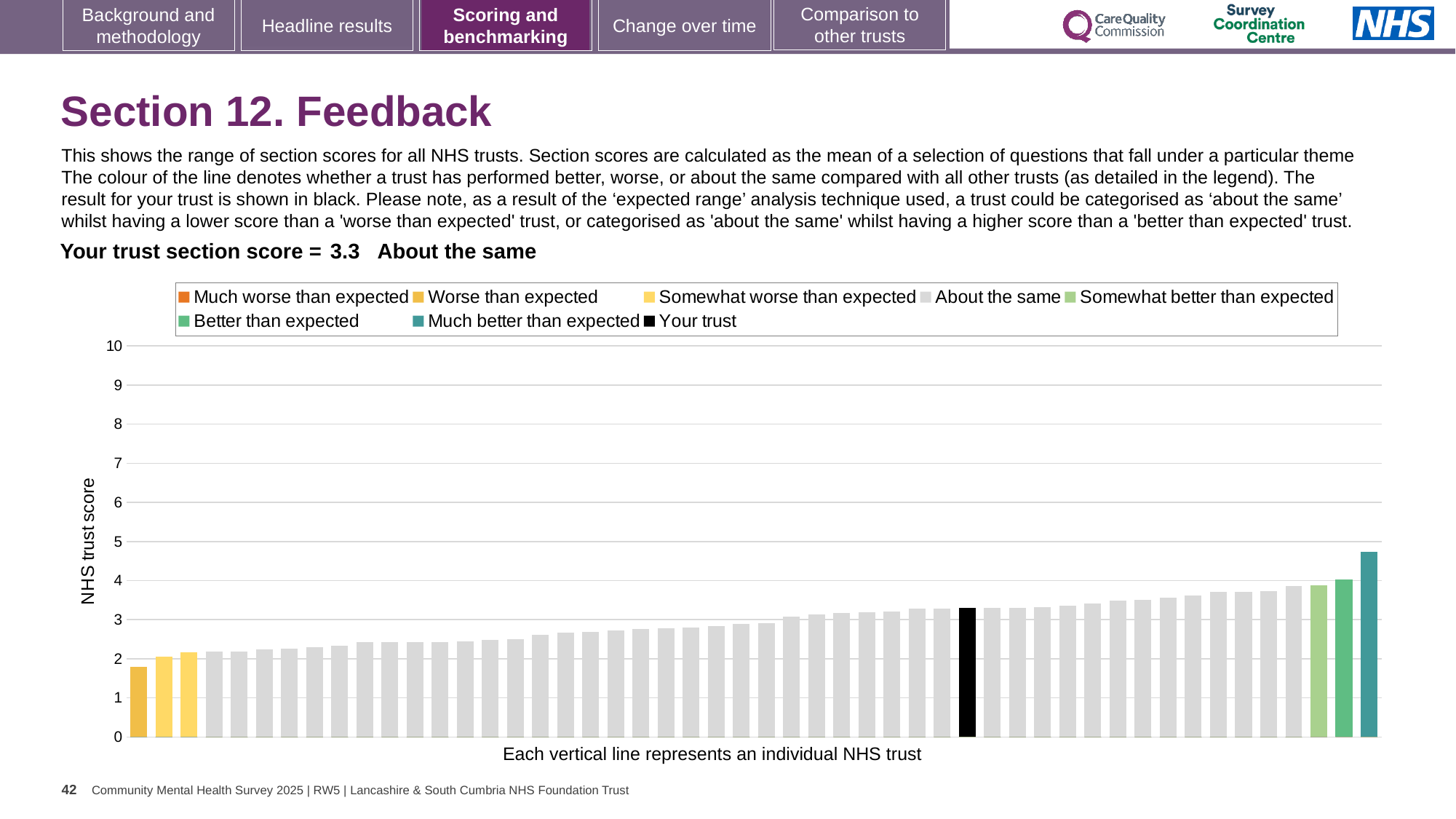
What is the highest value shown on the y axis? 10 What is the label of the y axis? NHS trust score What colour is the bar representing your trust? black Which category is your trust placed in for this section? About the same What is the section score for your trust shown on the slide? 3.3 What kind of chart is shown on the slide? bar chart Is the value of the tallest bar greater or less than 5? less Do the bar values rise or fall from left to right along the x axis? rise How many entries does the chart legend list? 8 Is the value of the shortest bar greater or less than 2? less Is the value of the black bar (your trust) greater or less than 3? greater